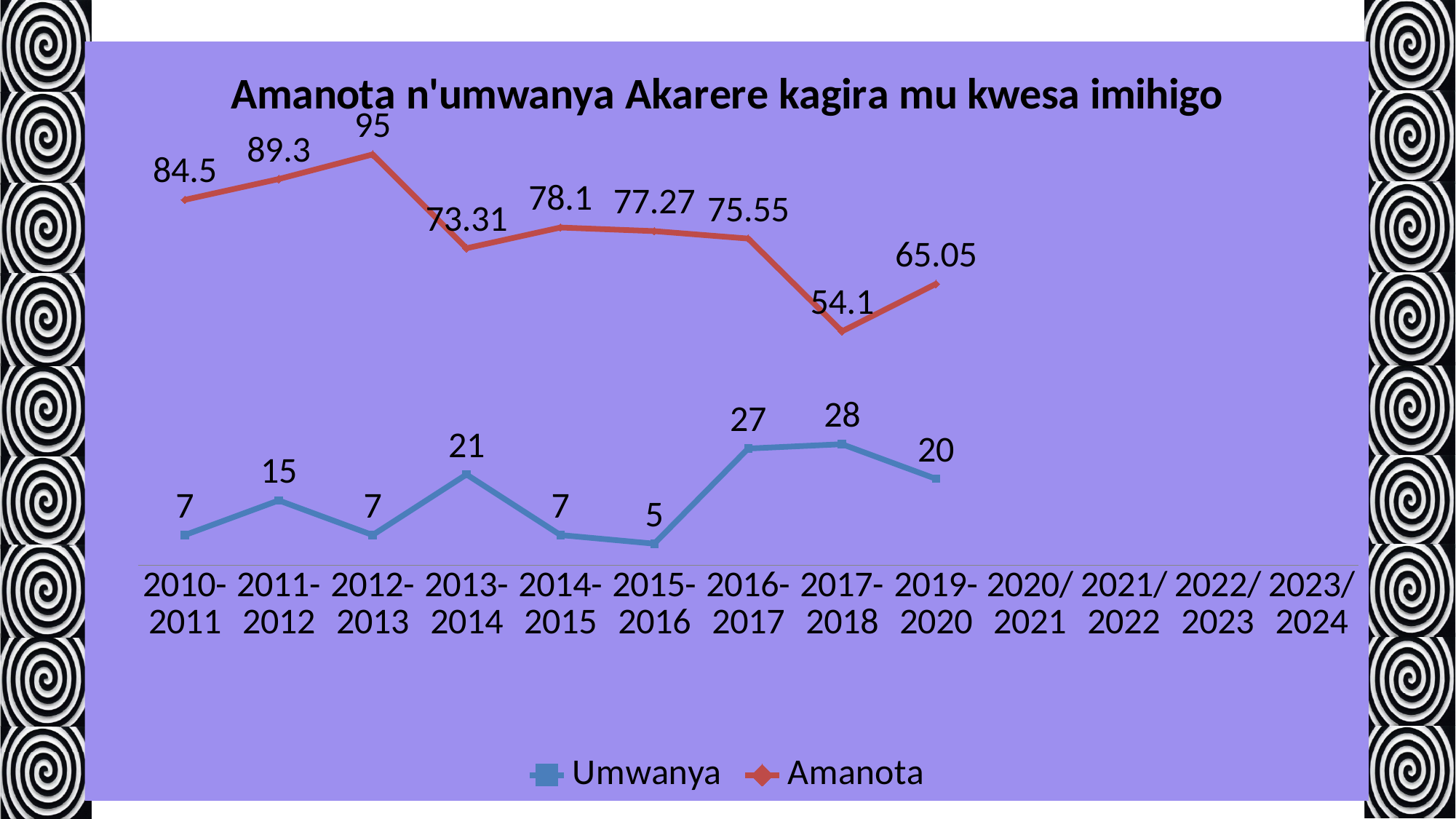
How many series does the legend list? 2 What is the difference between the Amanota values for 2012-2013 and 2013-2014? 21.69 In which period is the Umwanya value lowest? 2015-2016 What is the Umwanya value for 2017-2018? 28 What is the Amanota value for 2012-2013? 95 In which period is the Amanota value lowest? 2017-2018 What type of chart is shown on the slide? line chart Which is larger, the Umwanya value for 2013-2014 or for 2016-2017? 2016-2017 Does the Amanota series rise or fall from 2016-2017 to 2017-2018? fall What is the Amanota value for 2019-2020? 65.05 In which period is the Amanota value highest? 2012-2013 How many periods have data points plotted for the Amanota series? 9